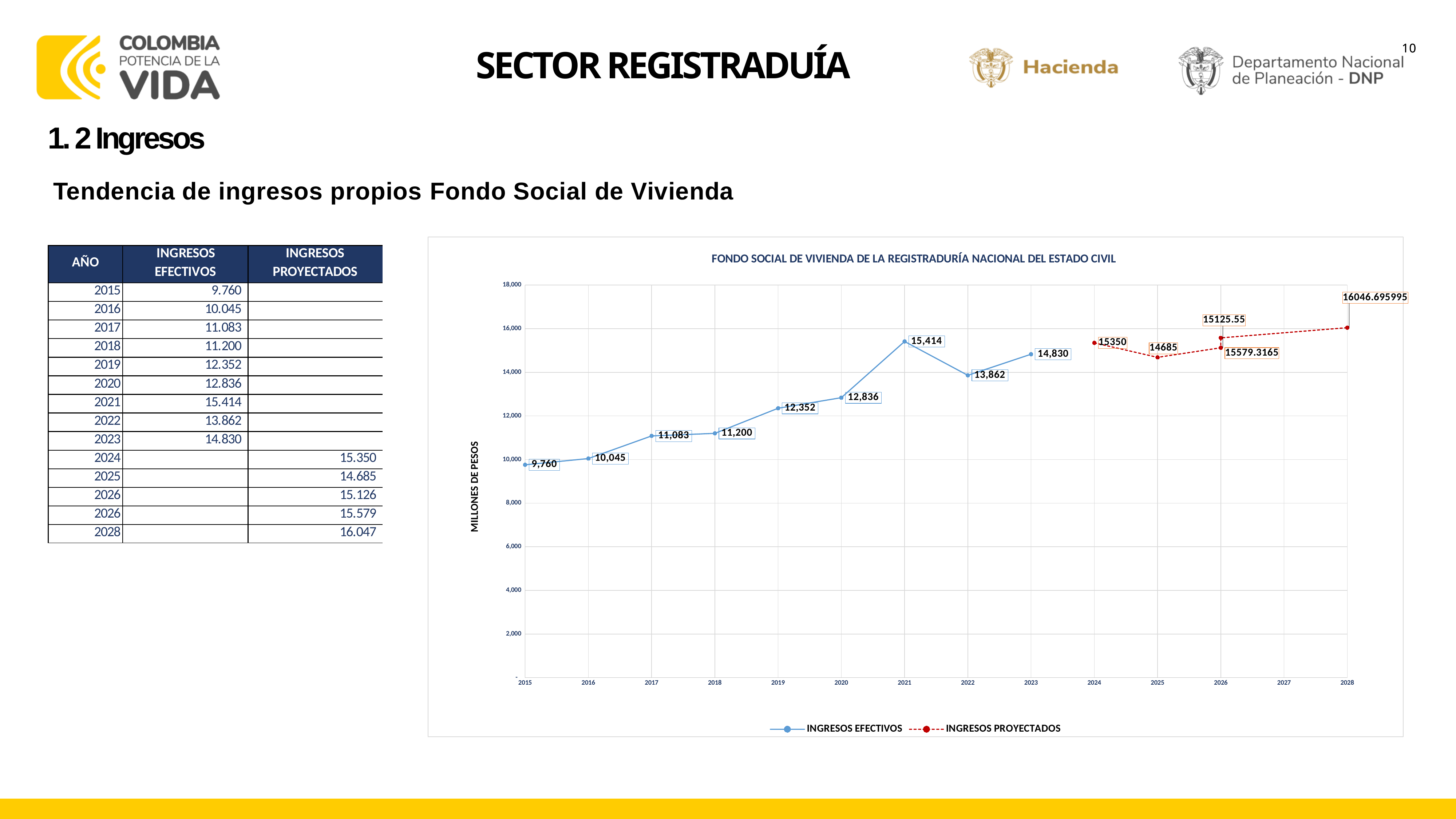
What is the title of the chart? FONDO SOCIAL DE VIVIENDA DE LA REGISTRADURÍA NACIONAL DEL ESTADO CIVIL How many series does the chart legend list? 2 What is the value of INGRESOS EFECTIVOS for 2015? 9,760 What type of chart is shown on the slide? line chart What is the value of INGRESOS PROYECTADOS for 2028? 16046.695995 What is the value of INGRESOS EFECTIVOS for 2021? 15,414 Which is larger, the INGRESOS EFECTIVOS value for 2023 or the INGRESOS PROYECTADOS value for 2024? INGRESOS PROYECTADOS for 2024 Which year has the lowest value for INGRESOS EFECTIVOS? 2015 Is the INGRESOS EFECTIVOS value for 2019 greater or less than 14,000? less What is the difference between the INGRESOS EFECTIVOS values for 2021 and 2022? 1,552 What is the value of INGRESOS PROYECTADOS for 2025? 14685 Which year has the highest value for INGRESOS EFECTIVOS? 2021